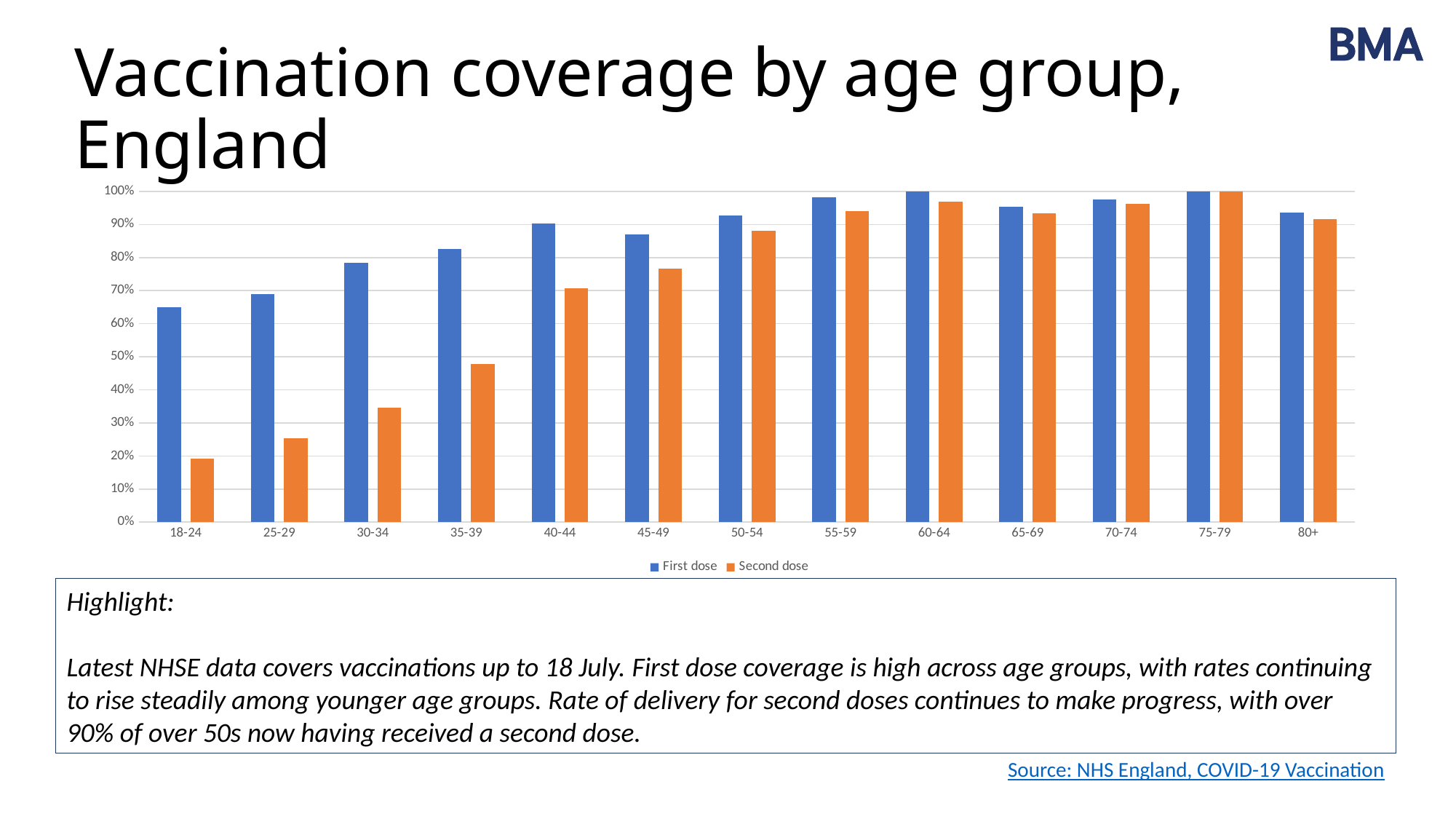
How many age groups are shown on the x axis of the chart? 13 How many series does the chart legend list? 2 Is the second dose value for 35-39 greater or less than 50%? less For the 18-24 age group, which is larger: first dose or second dose coverage? First dose Which age group has the lowest first dose coverage? 18-24 Is the second dose value for 45-49 greater or less than 70%? greater Is the second dose value for 18-24 greater or less than 30%? less Which age group has the highest second dose coverage? 75-79 Do second dose values generally rise or fall from 18-24 to 55-59? rise What kind of chart is shown on the slide? bar chart Which age group has the lowest second dose coverage? 18-24